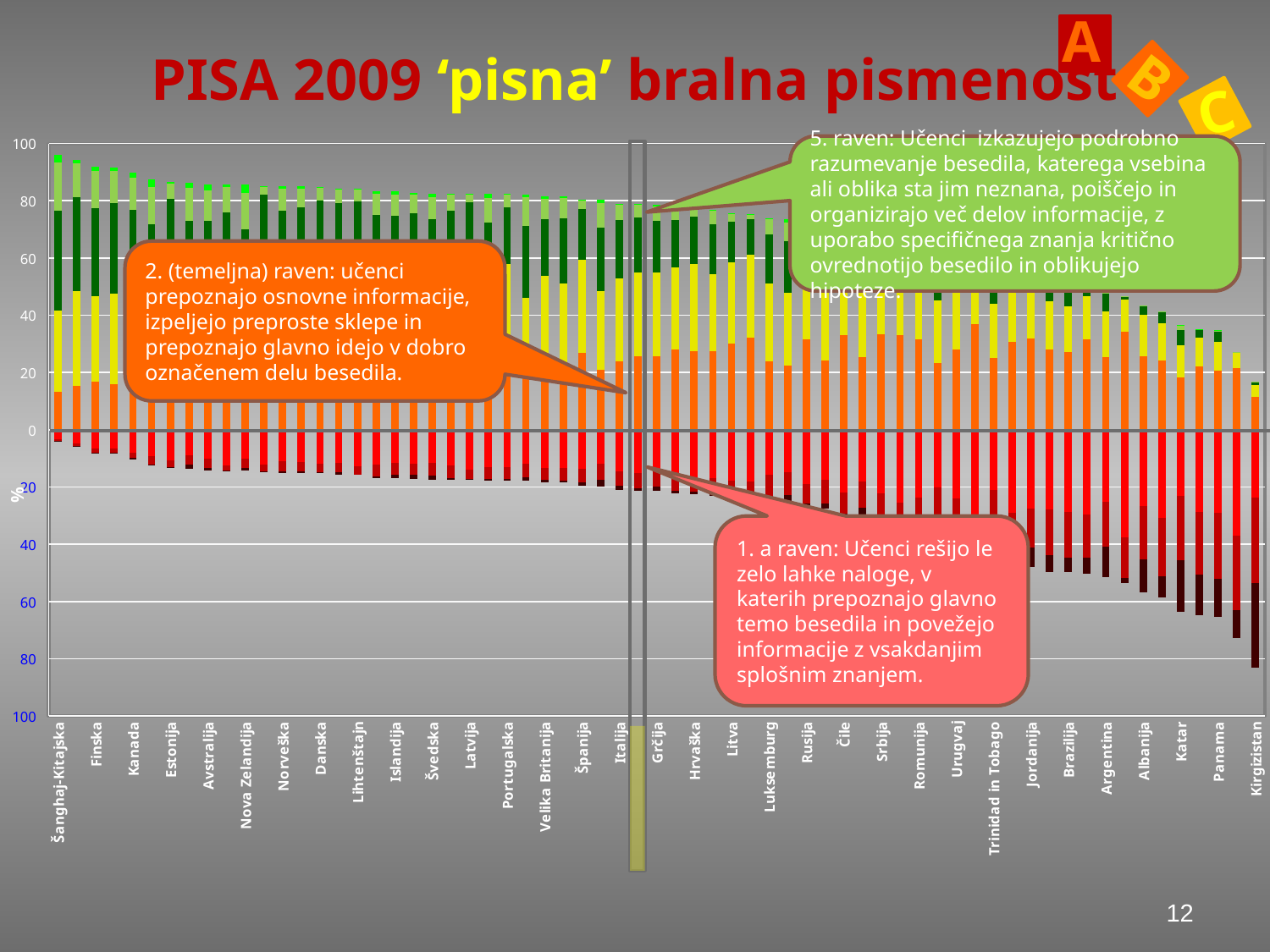
What kind of chart is shown on the slide? stacked bar chart Which country has the tallest stack above the zero line? Šanghaj-Kitajska Which country has the longest stack below the zero line? Kirgizistan What label is shown on the vertical axis of the chart? % Is the top of the stack above zero for Kirgizistan greater or less than 20? less Do the stacks above the zero line generally rise or fall moving from left to right along the x axis? fall Which has a taller stack above the zero line, Finska or Panama? Finska Which country has the shortest stack above the zero line? Kirgizistan Which country is the rightmost category on the x axis? Kirgizistan Is the top of the stack above zero for Šanghaj-Kitajska greater or less than 80? greater Which country is the leftmost category on the x axis? Šanghaj-Kitajska What is the title of the slide containing the chart? PISA 2009 'pisna' bralna pismenost